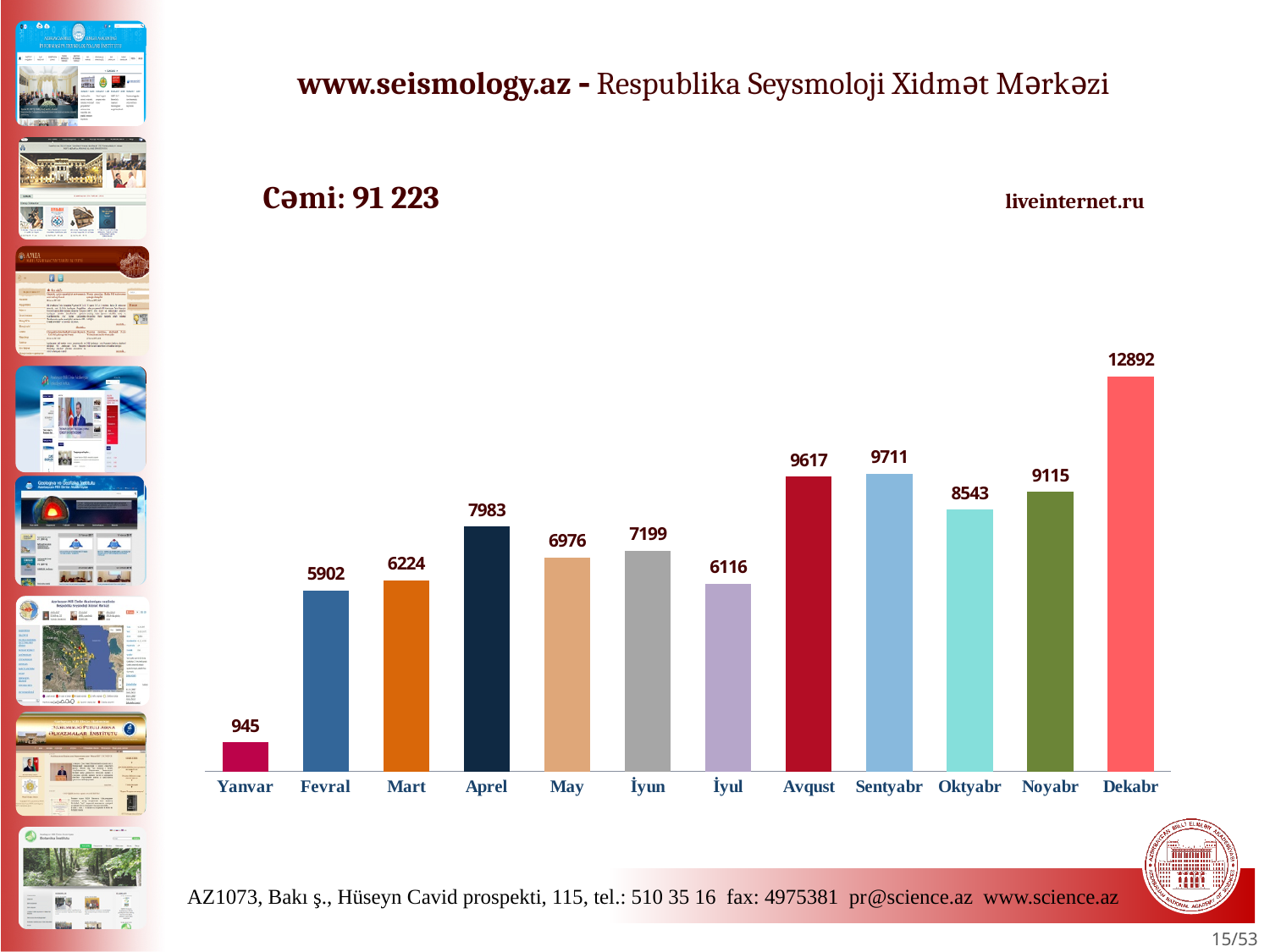
What is the difference between the values for Fevral and Yanvar? 4957 Which is larger, the value for May or the value for İyul? May What is the difference between the values for Dekabr and Noyabr? 3777 What is the value for Sentyabr? 9711 Which is larger, the value for Avqust or the value for Oktyabr? Avqust What is the value for Aprel? 7983 What total (Cəmi) is stated on the slide? 91 223 Do the values rise or fall from Avqust to Sentyabr? rise Which month has the highest value? Dekabr How many months are shown on the chart? 12 Which month has the lowest value? Yanvar What kind of chart is shown on the slide? bar chart